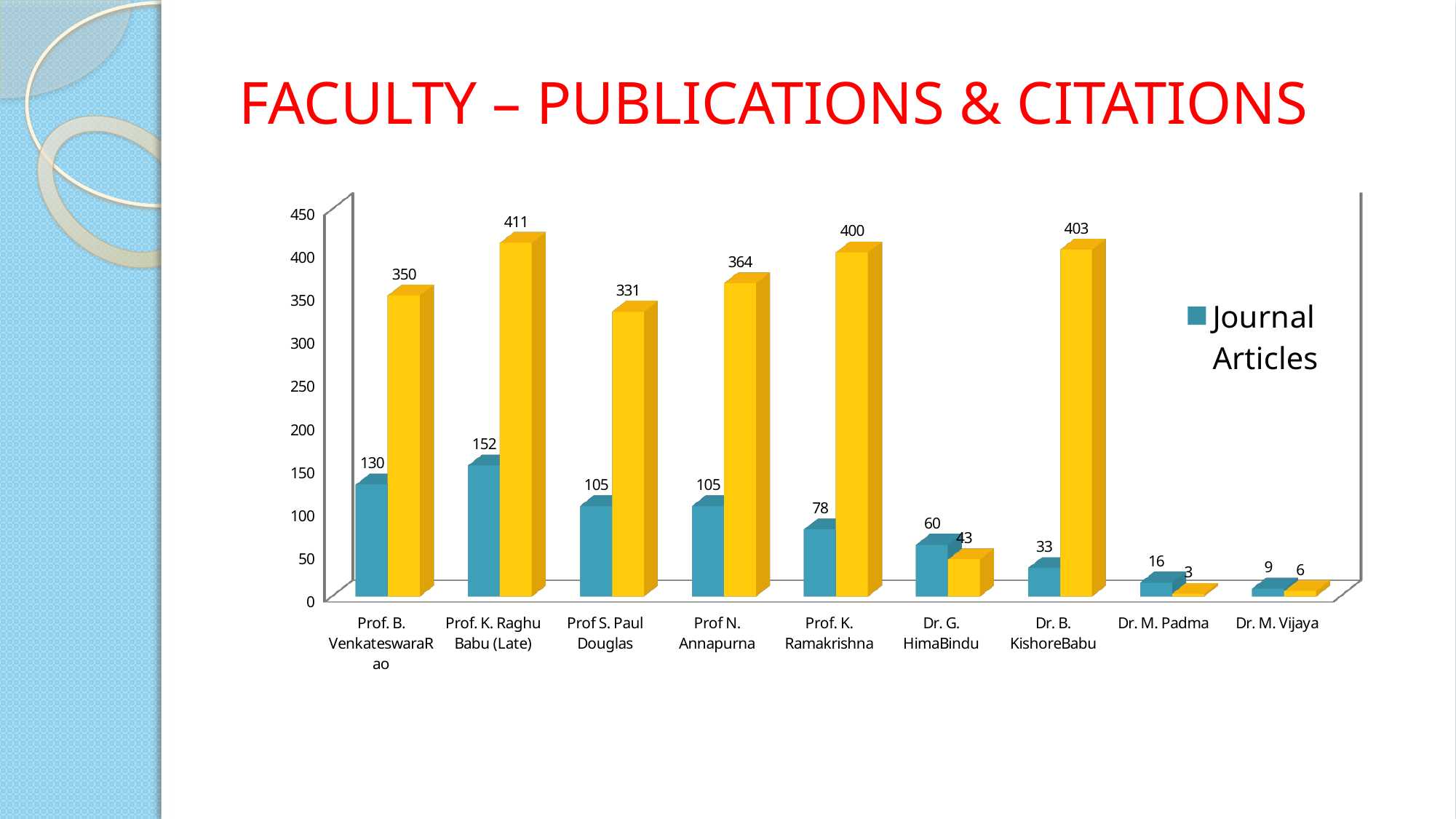
Which faculty member has the highest value in the yellow series? Prof. K. Raghu Babu (Late) How many faculty members are shown on the x axis? 9 What is the difference in Journal Articles between Prof. B. VenkateswaraRao and Dr. G. HimaBindu? 70 Whose yellow bar is larger, Prof N. Annapurna or Prof S. Paul Douglas? Prof N. Annapurna How many Journal Articles are shown for Prof. K. Raghu Babu (Late)? 152 Which faculty member has the lowest number of Journal Articles? Dr. M. Vijaya From Prof S. Paul Douglas to Dr. M. Vijaya, do the Journal Articles values rise or fall along the x axis? Fall What kind of chart is shown on the slide? Bar chart What is the value of the yellow bar for Prof. K. Ramakrishna? 400 What is the value of the yellow bar for Dr. M. Padma? 3 What is the title of the slide? FACULTY – PUBLICATIONS & CITATIONS Which faculty member has the highest number of Journal Articles? Prof. K. Raghu Babu (Late)